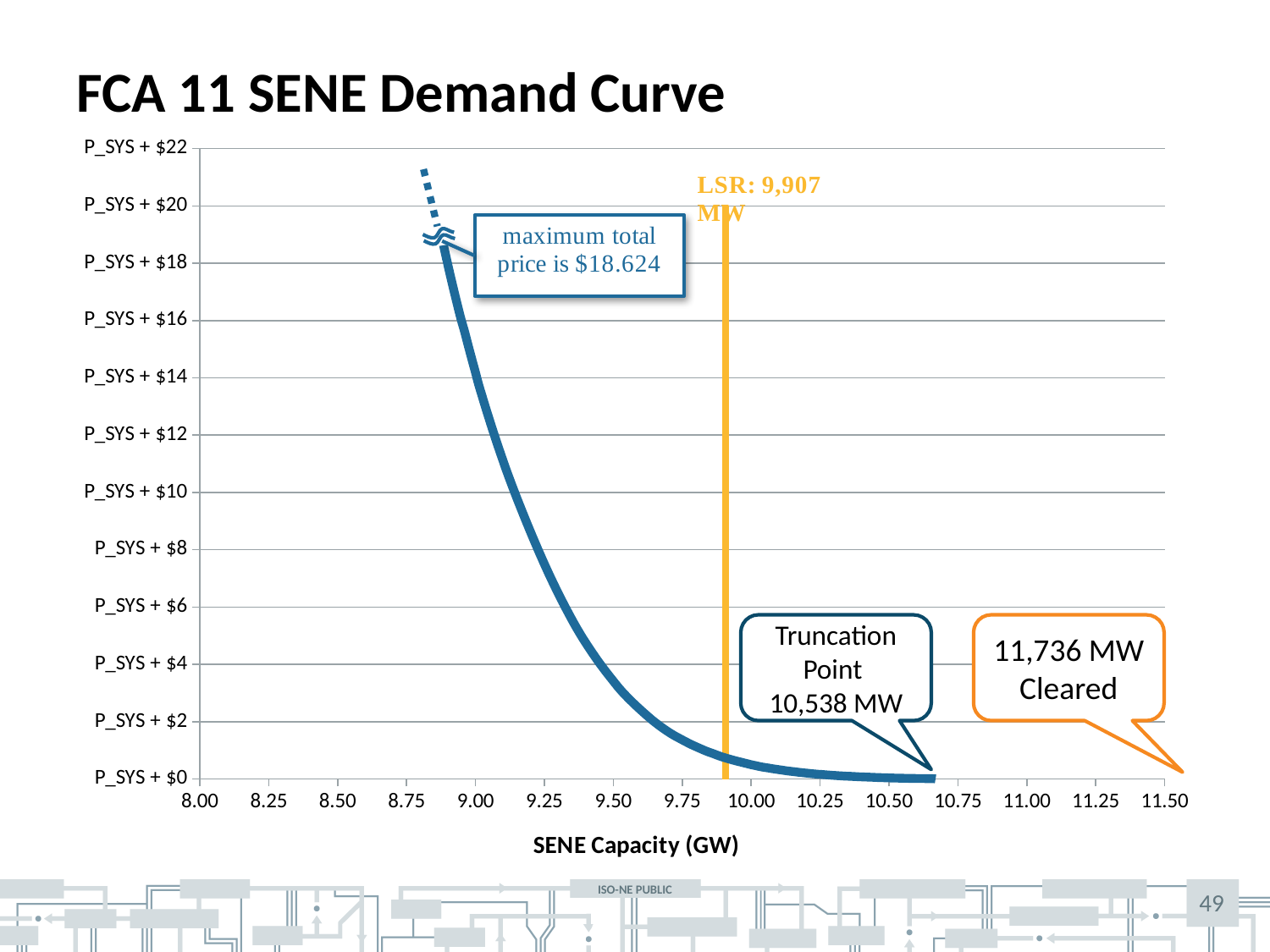
What capacity is labelled as the Truncation Point? 10,538 MW How many MW are labelled as Cleared on the chart? 11,736 MW What is the difference between the Truncation Point capacity and the LSR? 631 MW What is the maximum total price stated on the chart? $18.624 What is the title of the chart? FCA 11 SENE Demand Curve What kind of chart is shown on the slide? line chart What is the LSR value marked on the chart? 9,907 MW What is the difference between the MW Cleared and the Truncation Point capacity? 1,198 MW Does the demand curve rise or fall as SENE capacity increases? fall At 9.50 GW, is the demand curve price greater or less than P_SYS + $10? less What is the x-axis title of the chart? SENE Capacity (GW) Which is larger, the MW Cleared or the Truncation Point capacity? MW Cleared